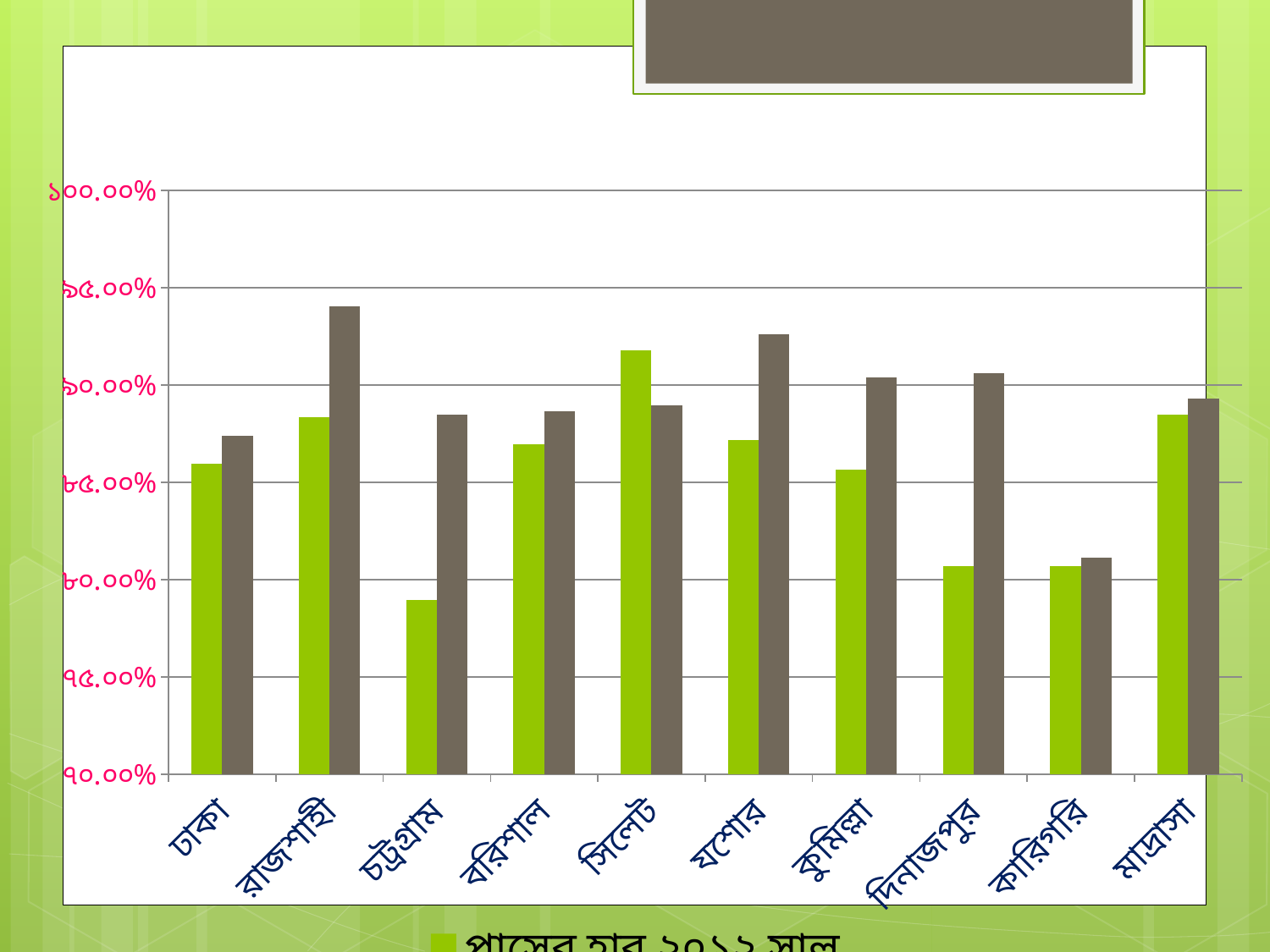
How many series of bars are plotted for each category in the chart? 2 For রাজশাহী, which bar is taller, the green bar or the grey bar? grey bar What kind of chart is shown on the slide? bar chart For সিলেট, which bar is taller, the green bar or the grey bar? green bar Is the grey bar for রাজশাহী greater or less than ৯০.০০%? greater Is the green bar for সিলেট greater or less than ৯০.০০%? greater Which category has the highest green bar in the chart? সিলেট Which category has the lowest green bar in the chart? চট্রগ্রাম Which category has the lowest grey bar in the chart? কারিগরি How many categories are shown along the x axis of the chart? 10 Is the green bar for চট্টগ্রাম greater or less than ৮০.০০%? less Which category has the highest grey bar in the chart? রাজশাহী